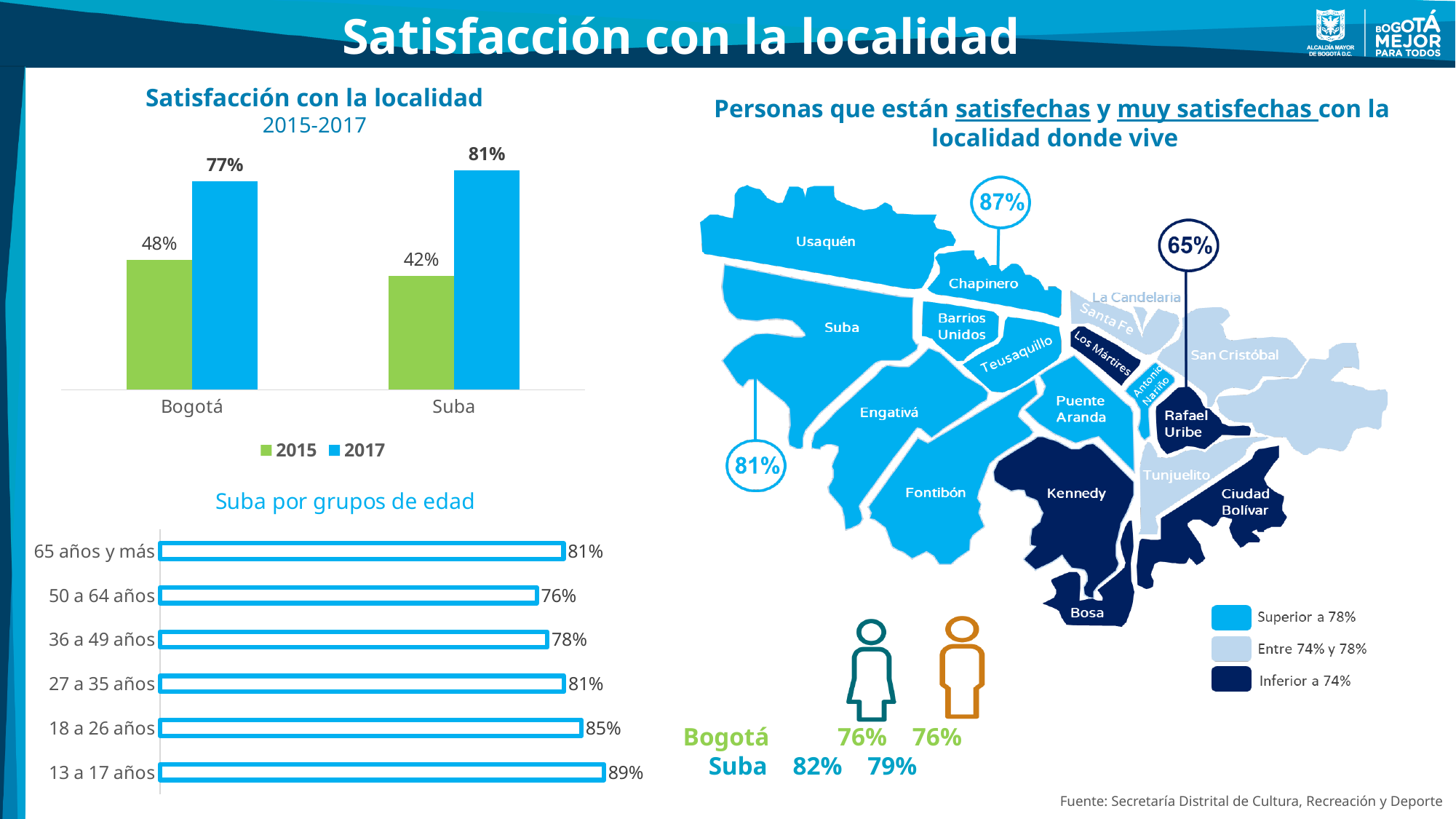
In the 'Suba por grupos de edad' chart, which age group has the highest value? 13 a 17 años In the 'Suba por grupos de edad' chart, which age group has the lowest value? 50 a 64 años How many age groups are shown in the 'Suba por grupos de edad' chart? 6 In the 'Satisfacción con la localidad 2015-2017' chart, which colour represents 2015? Green In the 'Satisfacción con la localidad 2015-2017' chart, what is the difference between Suba's 2017 and 2015 values? 39 percentage points What kind of chart is 'Satisfacción con la localidad 2015-2017'? Bar chart In the 'Satisfacción con la localidad 2015-2017' chart, which is larger: Bogotá in 2015 or Suba in 2015? Bogotá in 2015 In the 'Suba por grupos de edad' chart, what is the difference between '13 a 17 años' and '36 a 49 años'? 11 percentage points In the 'Satisfacción con la localidad 2015-2017' chart, what is the value for Bogotá in 2017? 77% In the 'Suba por grupos de edad' chart, what is the value for '18 a 26 años'? 85% How many series does the legend of the 'Satisfacción con la localidad 2015-2017' chart list? 2 In the 'Satisfacción con la localidad 2015-2017' chart, what is the value for Suba in 2015? 42%